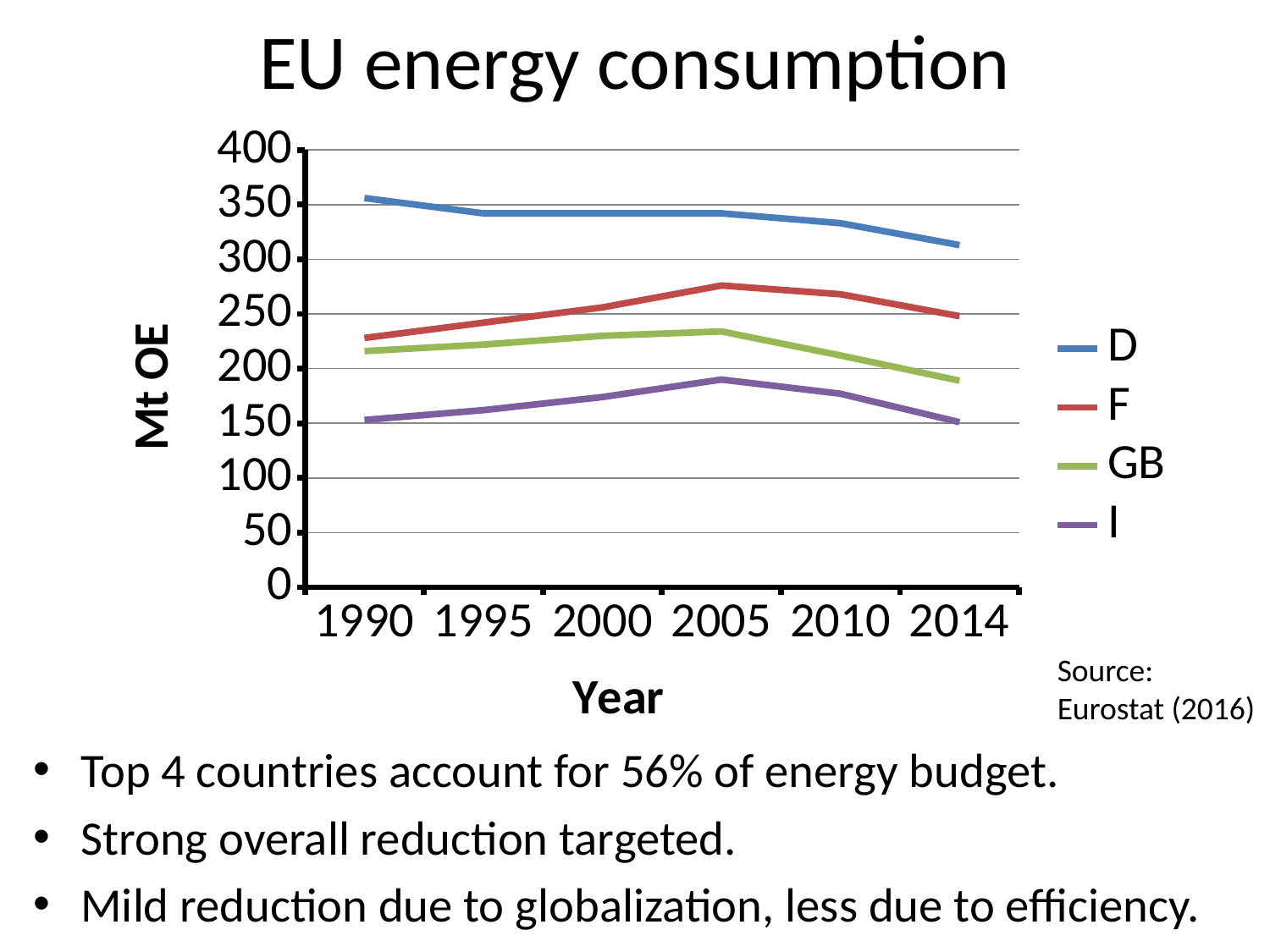
What kind of chart is shown on the slide? line chart Is the value for D in 2014 greater or less than 350? less How many years are plotted along the x axis? 6 Is the value for I in 2005 greater or less than 200? less How many series does the legend list? 4 Is the value for GB in 2014 greater or less than 200? less Which series has the highest energy consumption across all years? D What is the label on the y axis? Mt OE Does the value for D rise or fall from 1990 to 2014? fall Which series has the lowest energy consumption across all years? I Which is larger in 2014, the value for F or the value for GB? F